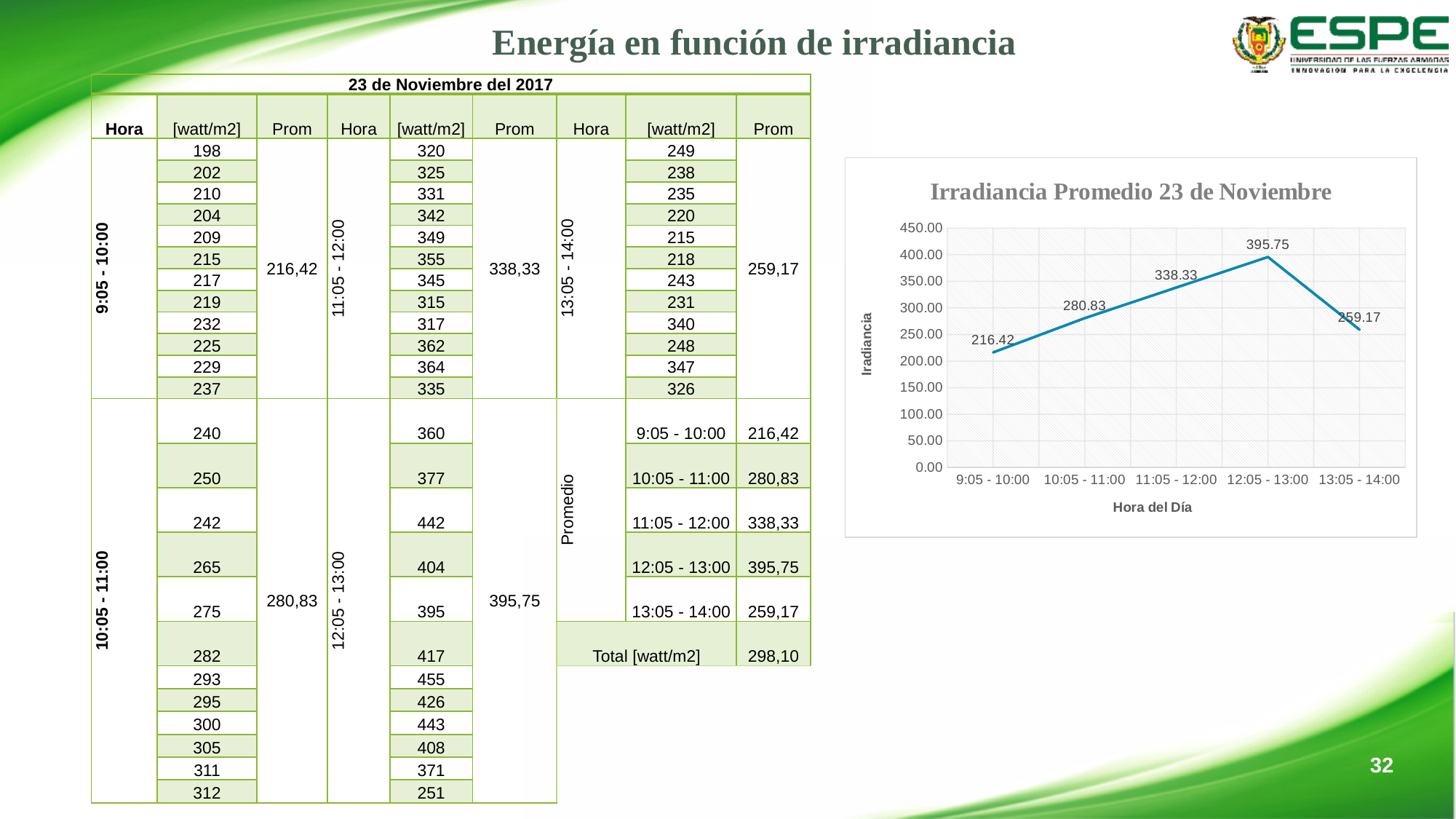
What is the value plotted for 9:05 - 10:00? 216.42 Do the values rise or fall from 9:05 - 10:00 to 12:05 - 13:00? rise Which time slot has the highest value in the chart? 12:05 - 13:00 What is the value plotted for 13:05 - 14:00? 259.17 What is the title of the chart? Irradiancia Promedio 23 de Noviembre Which time slot has the lowest value in the chart? 9:05 - 10:00 What is the difference between the values for 12:05 - 13:00 and 13:05 - 14:00? 136.58 What is the value plotted for 12:05 - 13:00? 395.75 How many time slots are plotted on the x axis of the chart? 5 Which is larger, the value for 10:05 - 11:00 or the value for 13:05 - 14:00? 10:05 - 11:00 What is the label of the x axis of the chart? Hora del Día What type of chart is shown on the slide? line chart